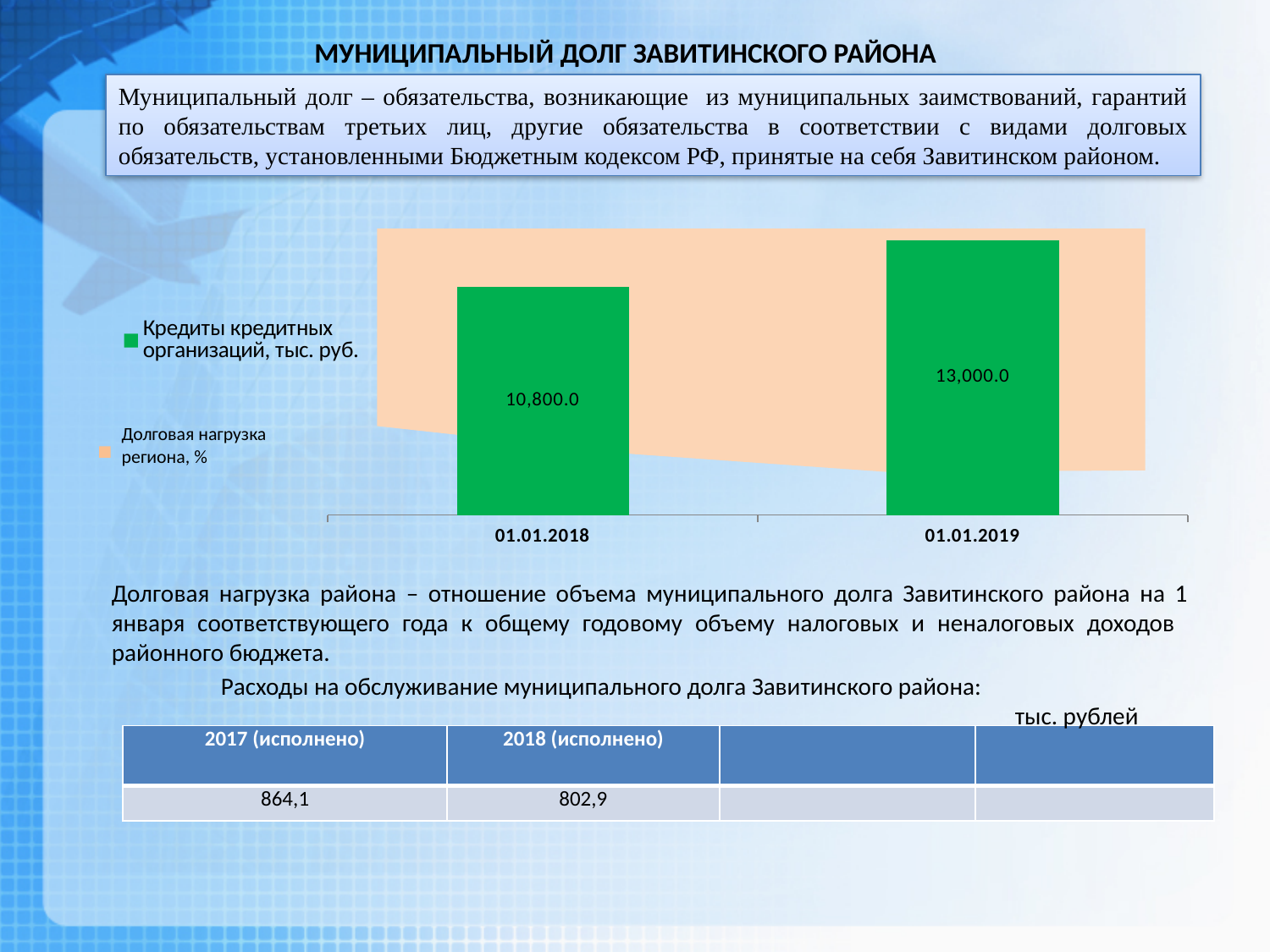
Does the value for Кредиты кредитных организаций rise or fall from 01.01.2018 to 01.01.2019? Rise By how much does the value for Кредиты кредитных организаций on 01.01.2019 exceed the value on 01.01.2018? 2,200.0 Which date has the higher value for Кредиты кредитных организаций? 01.01.2019 Is the value for Кредиты кредитных организаций larger on 01.01.2018 or on 01.01.2019? 01.01.2019 How many series does the chart legend list? 2 What kind of chart is used to show Кредиты кредитных организаций? Bar chart What is the name of the second series listed in the chart legend? Долговая нагрузка региона, % How many dates are shown on the x axis of the chart? 2 What is the value of Кредиты кредитных организаций for 01.01.2018? 10,800.0 What colour are the bars for Кредиты кредитных организаций? Green What is the value of Кредиты кредитных организаций for 01.01.2019? 13,000.0 Which date has the lower value for Кредиты кредитных организаций? 01.01.2018